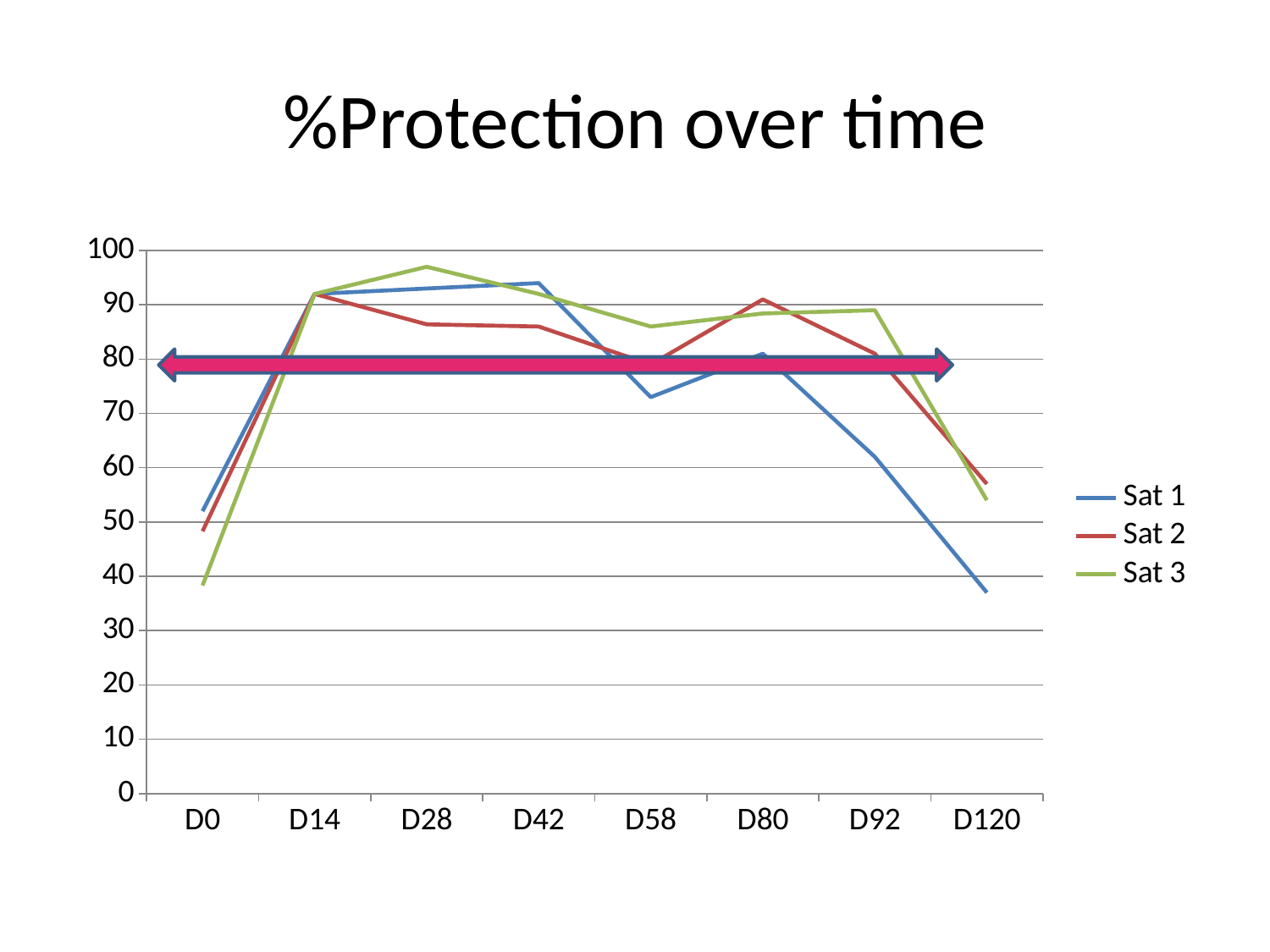
Which series has the lowest value at D120? Sat 1 Is the value for Sat 1 at D58 greater or less than 80? less Is the value for Sat 1 at D120 greater or less than 40? less Which series has the highest value at D0? Sat 1 Is the value for Sat 3 at D28 greater or less than 90? greater How many series does the legend list? 3 Does the Sat 1 line rise or fall from D42 to D120? fall What is the title of the chart? %Protection over time What kind of chart is shown on the slide? line chart How many time points are shown on the x axis? 8 At D92, which series has the larger value, Sat 1 or Sat 3? Sat 3